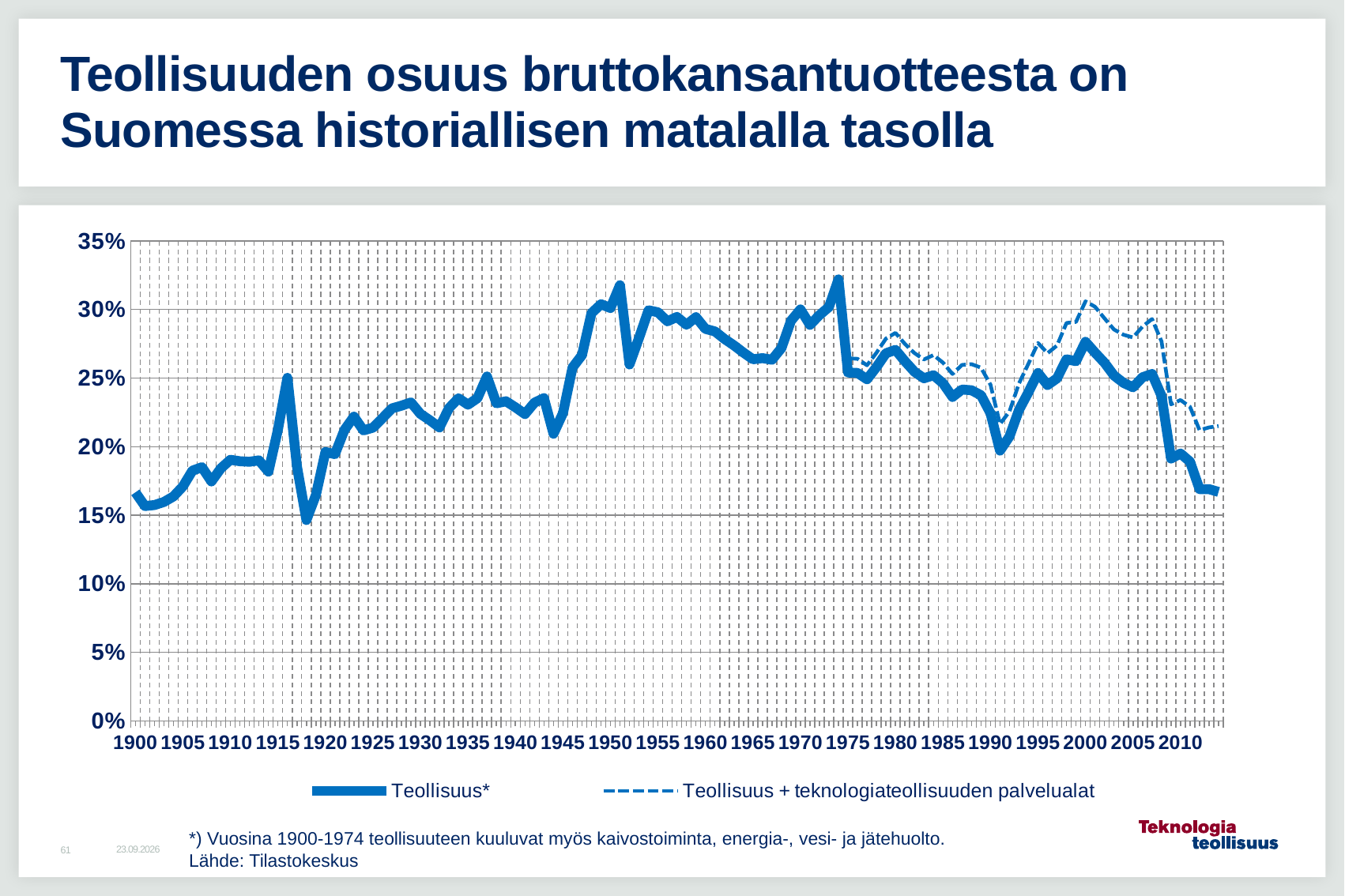
What kind of chart is shown on the slide? line chart In 2000, which series has the higher value: Teollisuus* or Teollisuus + teknologiateollisuuden palvelualat? Teollisuus + teknologiateollisuuden palvelualat Does the Teollisuus* series rise or fall between 1945 and 1950? rise Is the value of Teollisuus* at the end of the series (around 2013) greater or less than 20%? less Does the Teollisuus* series rise or fall between 2007 and the end of the series? fall Is the value of Teollisuus* in 1900 greater or less than 20%? less Is the value of Teollisuus + teknologiateollisuuden palvelualat in 1990 greater or less than 20%? greater Which series is drawn with a dashed line? Teollisuus + teknologiateollisuuden palvelualat How many series does the legend list? 2 What is the title of the chart slide? Teollisuuden osuus bruttokansantuotteesta on Suomessa historiallisen matalalla tasolla